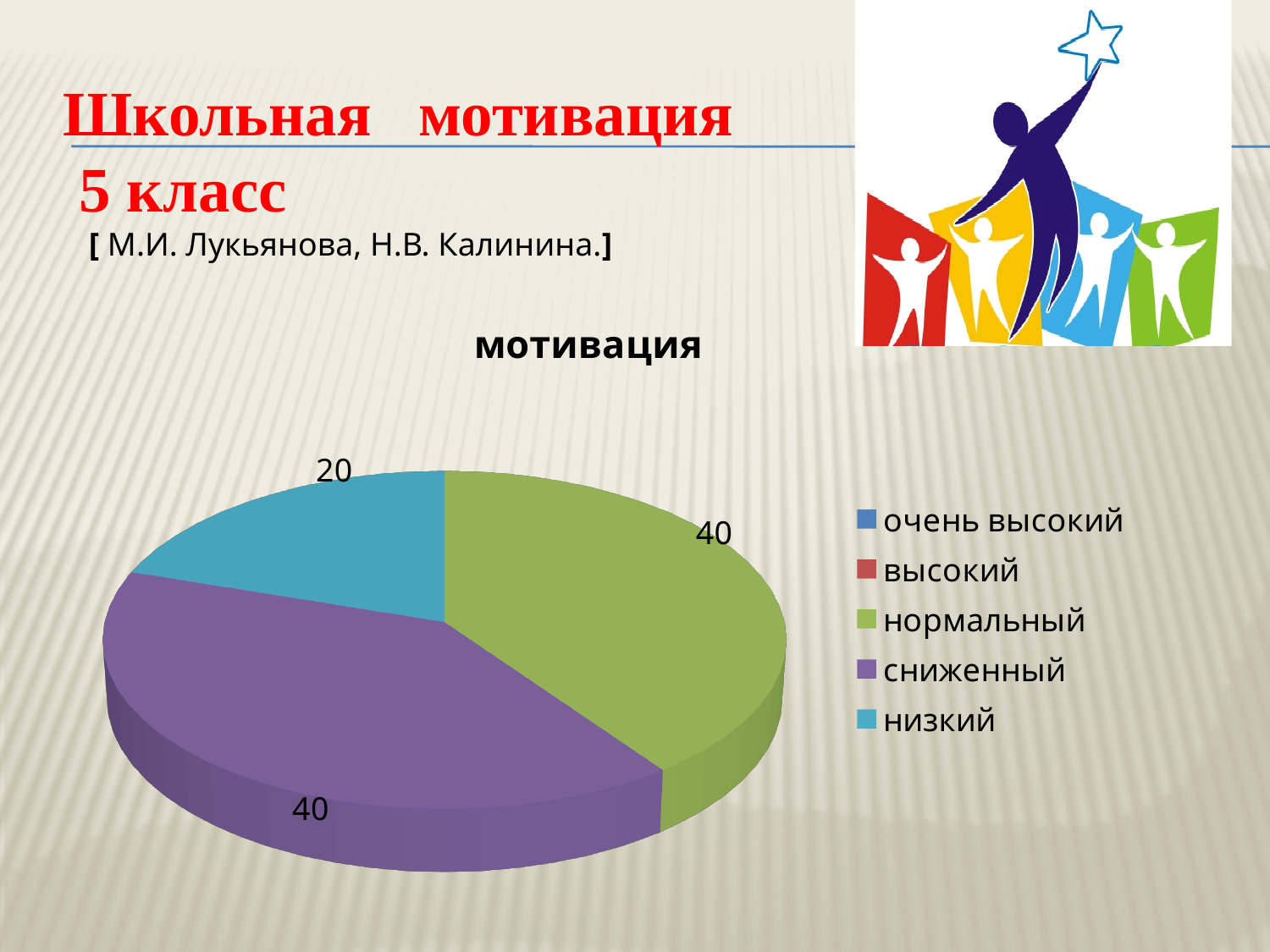
Which category has the smallest visible slice in the pie? низкий Which is larger, the 'сниженный' slice or the 'низкий' slice? сниженный What is the title of the chart? мотивация What is the value for the 'сниженный' slice? 40 What kind of chart is shown on the slide? pie chart How many entries does the chart legend list? 5 What share of the pie does the 'низкий' slice represent? 20% What is the difference between the 'нормальный' value and the 'низкий' value? 20 What is the value for the 'низкий' slice? 20 How many slices are visible in the pie? 3 What is the value for the 'нормальный' slice? 40 What colour is the 'сниженный' slice? purple